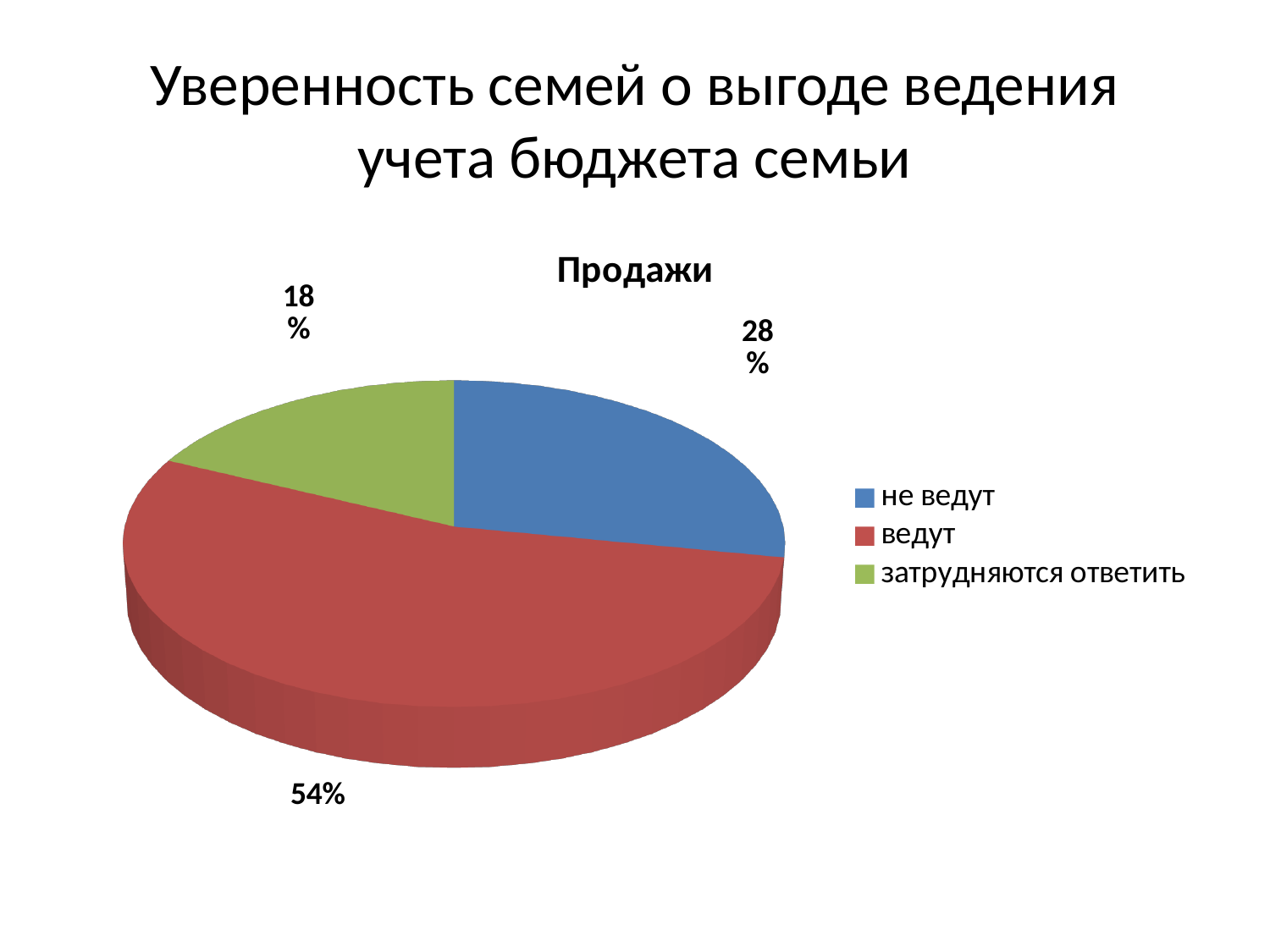
What is the difference in percentage points between the 'ведут' and 'не ведут' slices? 26 Which category has the largest slice of the pie? ведут What share of the pie does the 'затрудняются ответить' slice represent? 18% How many slices does the pie chart have? 3 Which is larger, the 'не ведут' slice or the 'затрудняются ответить' slice? не ведут What share of the pie does the 'ведут' slice represent? 54% What is the title shown above the pie chart? Продажи Which category has the smallest slice of the pie? затрудняются ответить What share of the pie does the 'не ведут' slice represent? 28% How many entries does the legend list? 3 What colour is the 'ведут' slice? red What kind of chart is shown on the slide? pie chart